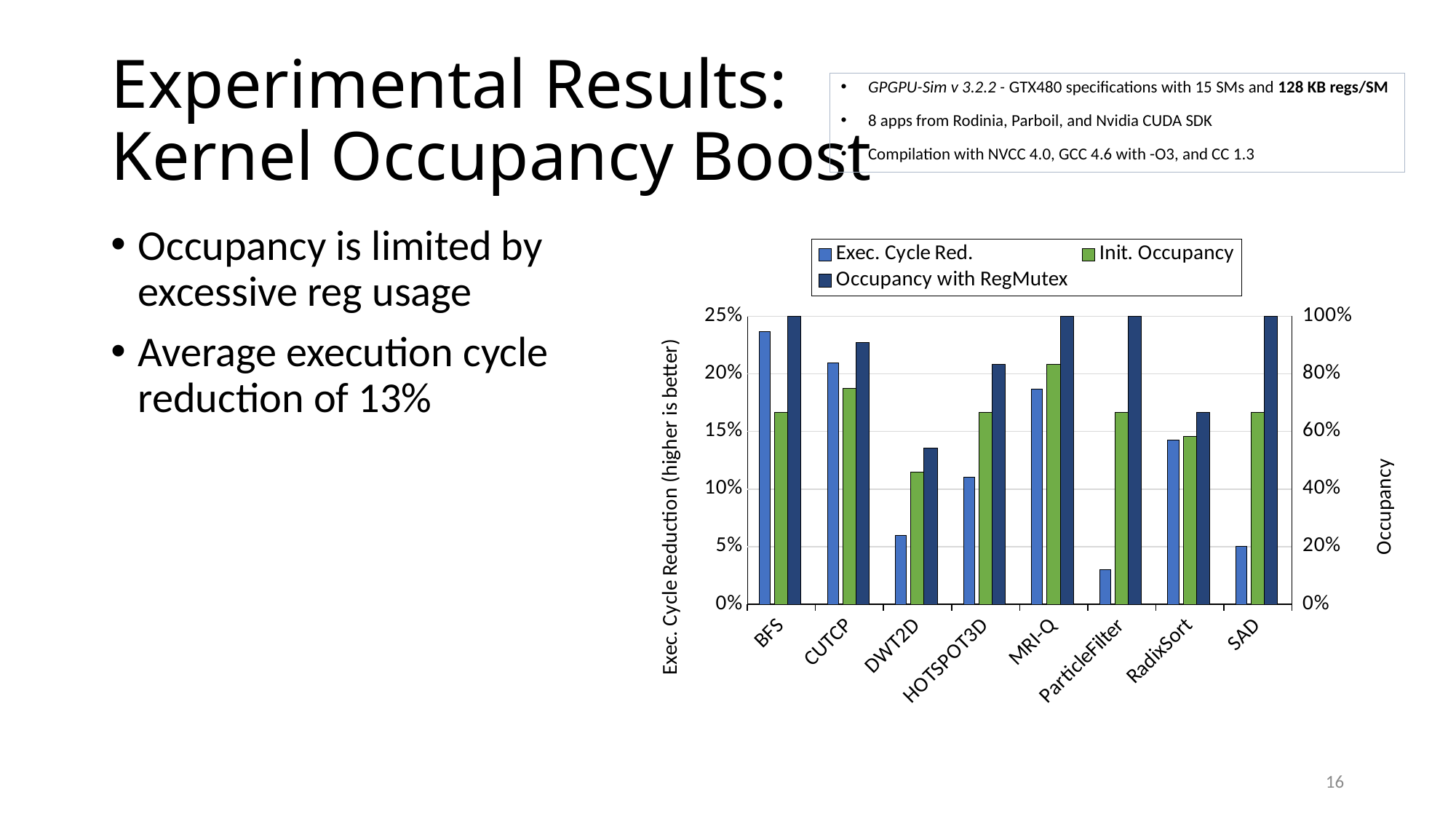
What is the Occupancy with RegMutex value for BFS? 100% Which application has the lowest Exec. Cycle Red. value? ParticleFilter How many applications (categories) are shown on the x axis of the chart? 8 Is the Init. Occupancy value for MRI-Q greater or less than 80%? greater Which application has the highest Exec. Cycle Red. value? BFS What kind of chart is shown on the slide? bar chart Is the Exec. Cycle Red. value for DWT2D greater or less than 10%? less Which is larger for HOTSPOT3D: Init. Occupancy or Occupancy with RegMutex? Occupancy with RegMutex How many series does the chart's legend list? 3 Is the Exec. Cycle Red. value for CUTCP greater or less than 20%? greater What is the Occupancy with RegMutex value for ParticleFilter? 100% What is the title of the right-hand vertical axis of the chart? Occupancy